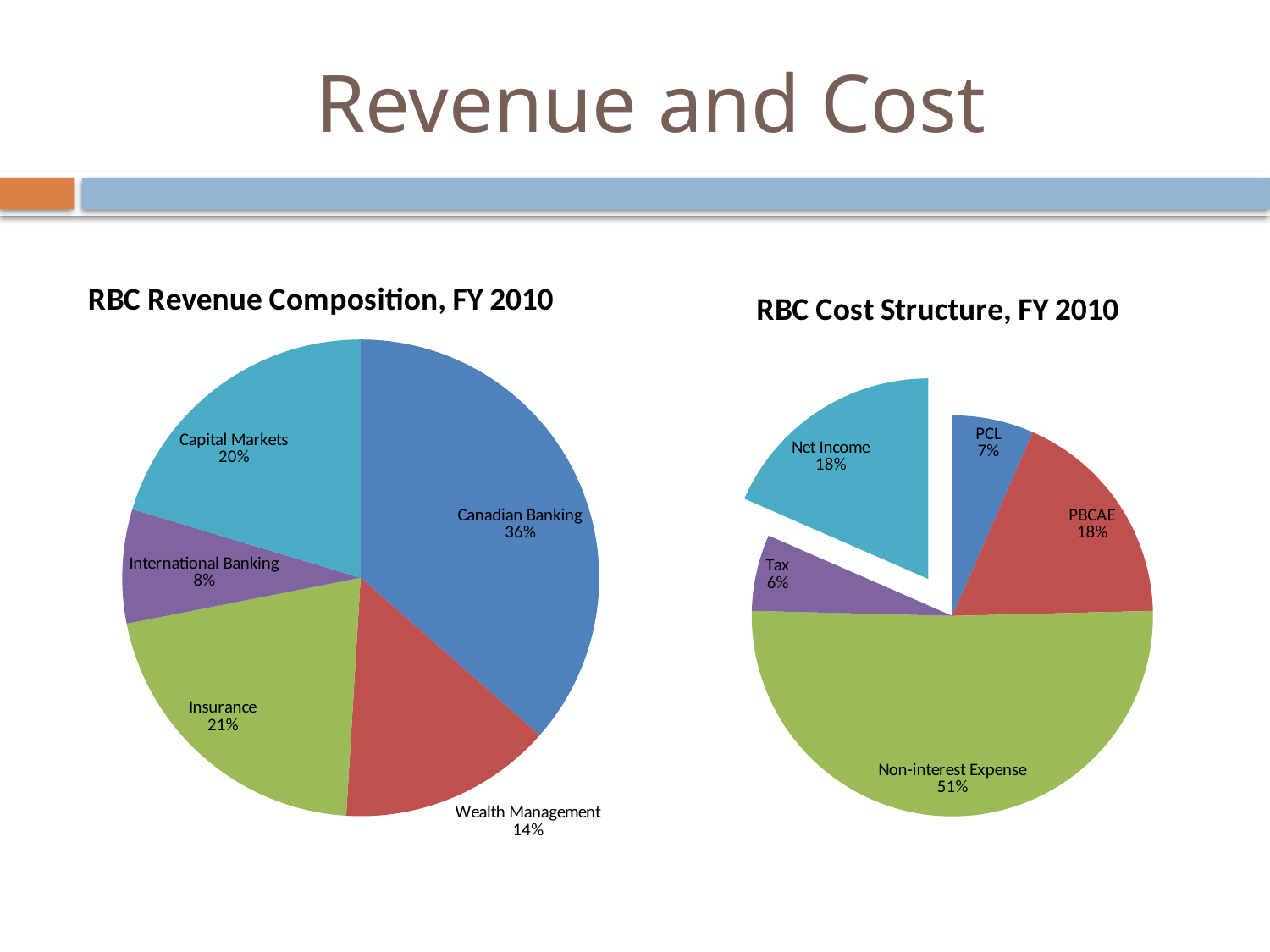
In the RBC Revenue Composition, FY 2010 chart, which segment has the largest share? Canadian Banking In the RBC Revenue Composition, FY 2010 chart, what share does Wealth Management have? 14% In the RBC Cost Structure, FY 2010 chart, what share does Tax have? 6% In the RBC Cost Structure, FY 2010 chart, what share does Non-interest Expense have? 51% In the RBC Cost Structure, FY 2010 chart, which is larger, PCL or PBCAE? PBCAE In the RBC Revenue Composition, FY 2010 chart, what share does Canadian Banking have? 36% What type of chart is the RBC Cost Structure, FY 2010 chart? Pie chart In the RBC Cost Structure, FY 2010 chart, which slice is pulled out from the pie? Net Income In the RBC Revenue Composition, FY 2010 chart, which segment has the smallest share? International Banking In the RBC Revenue Composition, FY 2010 chart, how many segments are shown? 5 In the RBC Cost Structure, FY 2010 chart, which category has the smallest share? Tax In the RBC Revenue Composition, FY 2010 chart, what is the difference in percentage points between Canadian Banking and Capital Markets? 16